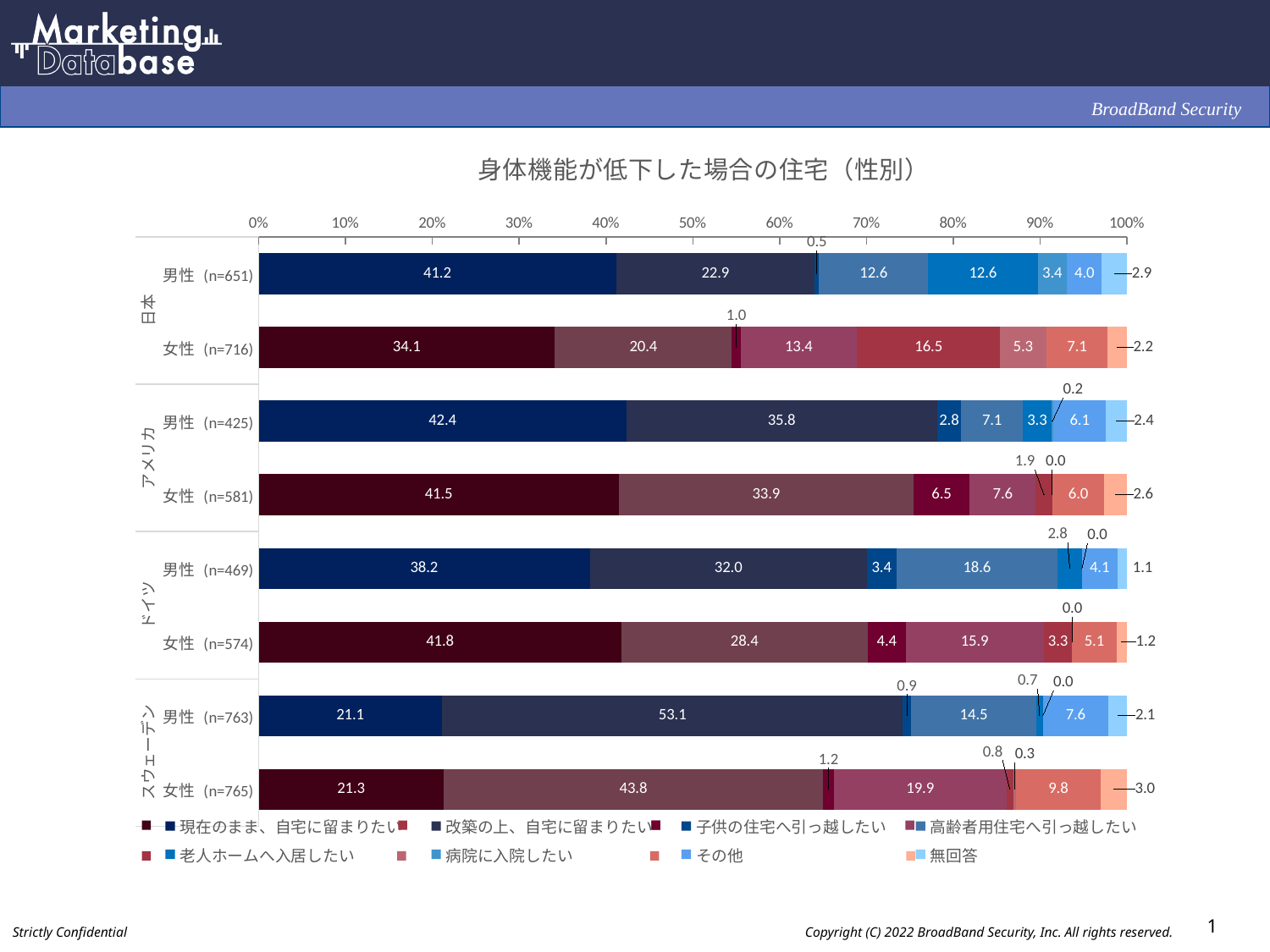
What is the value of 老人ホームへ入居したい for 日本 女性 (n=716)? 16.5 What is the value of 高齢者用住宅へ引っ越したい for ドイツ 男性 (n=469)? 18.6 What is the value of 改築の上、自宅に留まりたい for スウェーデン 男性 (n=763)? 53.1 Which group has the lowest value for 現在のまま、自宅に留まりたい? スウェーデン 男性 (n=763) Which group has the highest value for 改築の上、自宅に留まりたい? スウェーデン 男性 (n=763) Which is larger: the 子供の住宅へ引っ越したい value for アメリカ 女性 (n=581) or for アメリカ 男性 (n=425)? アメリカ 女性 (n=581) How many series does the legend list? 8 How many bars (respondent groups) are plotted in the chart? 8 What kind of chart is shown on the slide? Stacked bar chart What is the value of 現在のまま、自宅に留まりたい for 日本 男性 (n=651)? 41.2 What is the title of the chart? 身体機能が低下した場合の住宅（性別） What is the difference between the 現在のまま、自宅に留まりたい values for 日本 男性 (n=651) and 日本 女性 (n=716)? 7.1